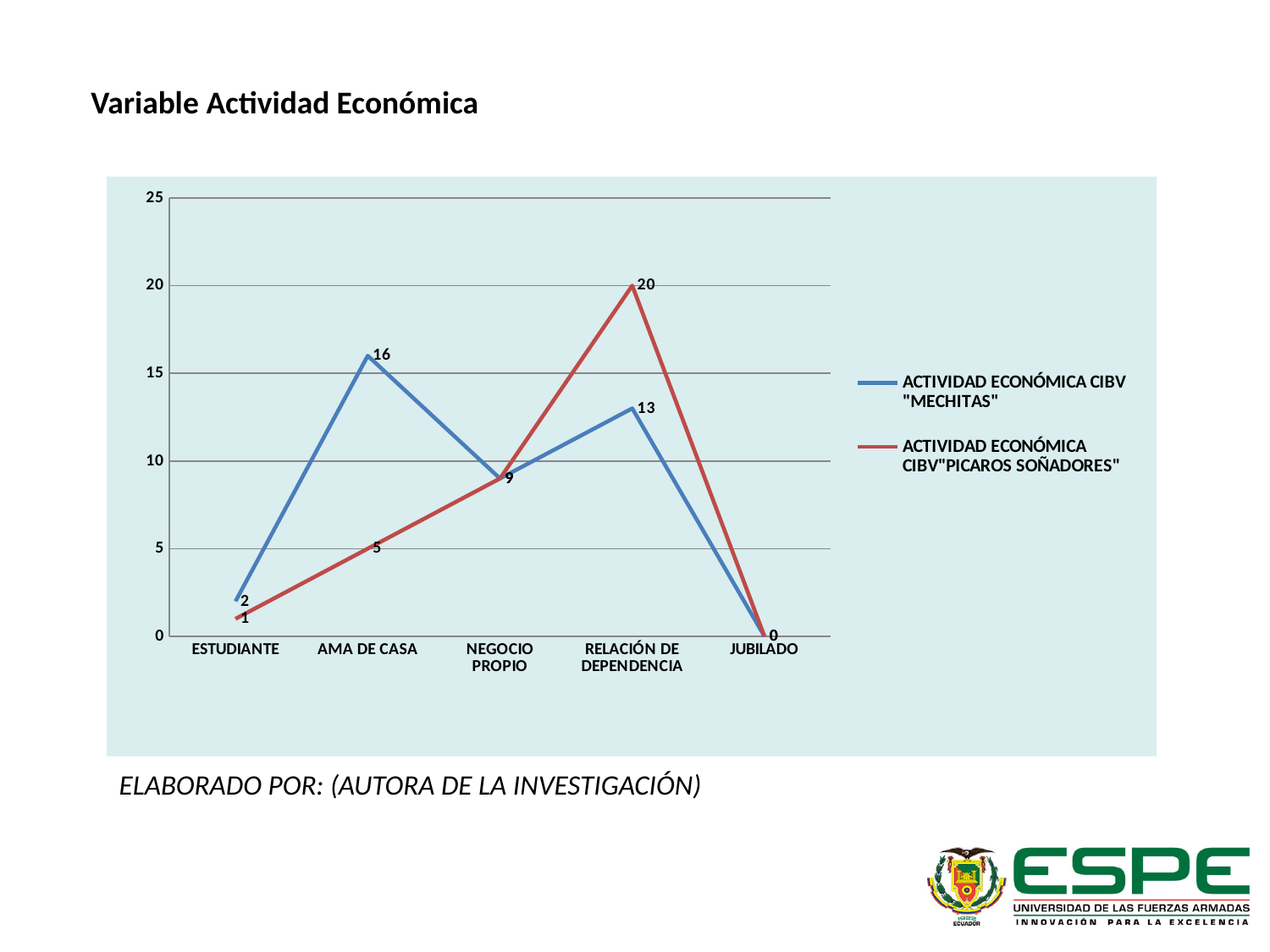
What kind of chart is shown on the slide? line chart How many series does the legend list? 2 What is the value for AMA DE CASA in the ACTIVIDAD ECONÓMICA CIBV"PICAROS SOÑADORES" series? 5 What is the value for AMA DE CASA in the ACTIVIDAD ECONÓMICA CIBV "MECHITAS" series? 16 What is the value for RELACIÓN DE DEPENDENCIA in the ACTIVIDAD ECONÓMICA CIBV"PICAROS SOÑADORES" series? 20 Which category has the highest value in the ACTIVIDAD ECONÓMICA CIBV "MECHITAS" series? AMA DE CASA How many categories are shown on the x axis? 5 For AMA DE CASA, which series has the larger value? ACTIVIDAD ECONÓMICA CIBV "MECHITAS" Which category has the highest value in the ACTIVIDAD ECONÓMICA CIBV"PICAROS SOÑADORES" series? RELACIÓN DE DEPENDENCIA What is the difference between the two series' values for RELACIÓN DE DEPENDENCIA? 7 What is the value for ESTUDIANTE in the ACTIVIDAD ECONÓMICA CIBV "MECHITAS" series? 2 What colour is the line for the ACTIVIDAD ECONÓMICA CIBV"PICAROS SOÑADORES" series? red